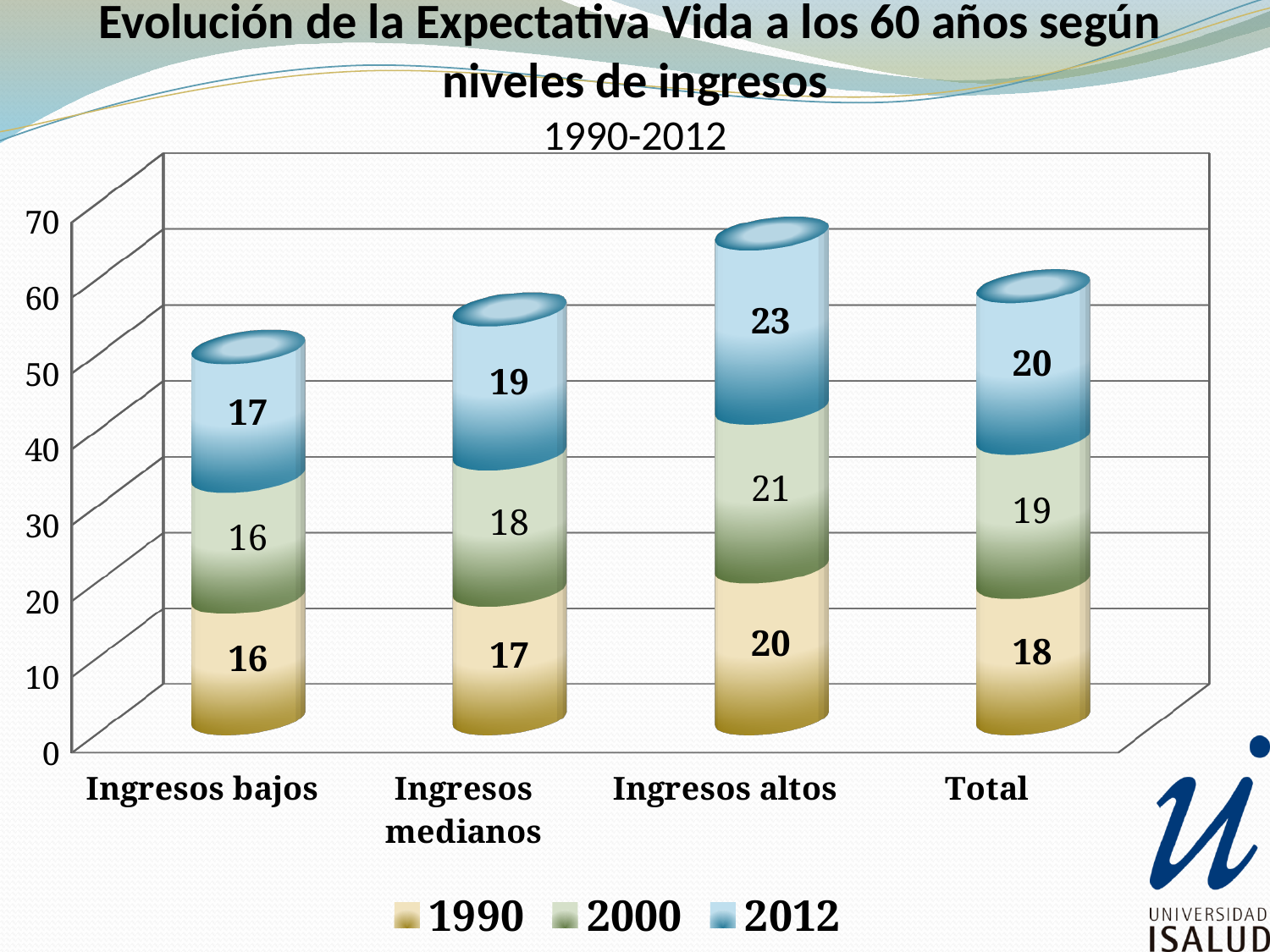
Do the 2012 values rise or fall from Ingresos bajos to Ingresos altos? Rise What is the 2012 value for Ingresos altos? 23 What is the difference between the 2012 values for Ingresos altos and Ingresos bajos? 6 Which category has the highest 2012 value? Ingresos altos What kind of chart is shown on the slide? Stacked bar chart What is the total of the stacked bar for Ingresos altos? 64 How many series does the legend list? 3 What is the 2000 value for Total? 19 Which category has the lowest 1990 value? Ingresos bajos How many categories are shown on the x axis? 4 What is the 1990 value for Ingresos medianos? 17 Which is larger: the 2000 value for Ingresos medianos or the 2000 value for Ingresos altos? Ingresos altos